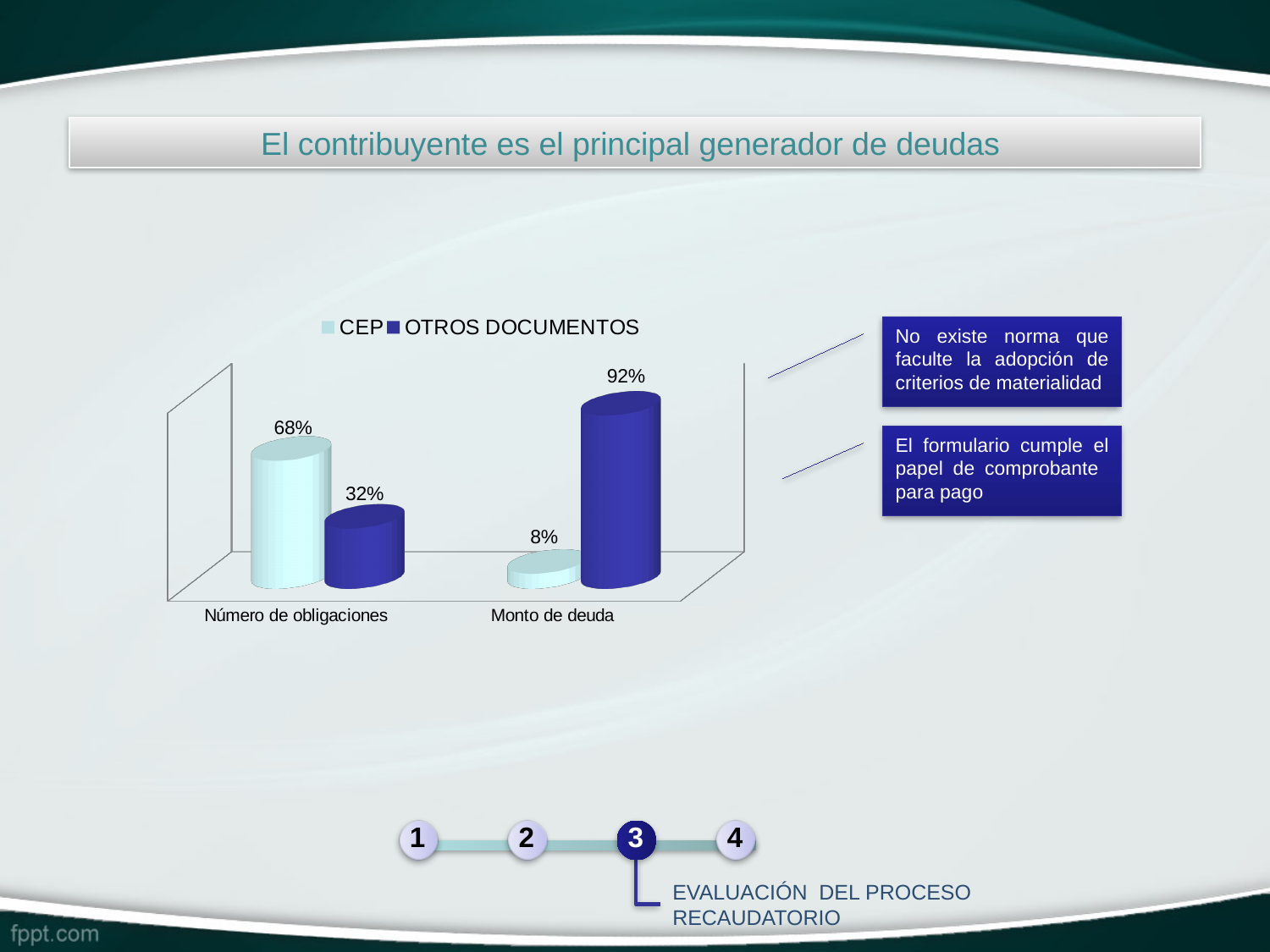
How many series does the legend list? 2 Which series has the lowest value in the Número de obligaciones category? OTROS DOCUMENTOS What is the value for OTROS DOCUMENTOS in the Monto de deuda category? 92% How many categories are shown on the x axis? 2 Which is larger: the CEP value for Número de obligaciones or the CEP value for Monto de deuda? Número de obligaciones Which series has the highest value in the Monto de deuda category? OTROS DOCUMENTOS What is the value for CEP in the Número de obligaciones category? 68% What is the value for CEP in the Monto de deuda category? 8% What is the value for OTROS DOCUMENTOS in the Número de obligaciones category? 32% What is the difference between the CEP and OTROS DOCUMENTOS values in the Número de obligaciones category? 36% What kind of chart is shown on the slide? Bar chart What is the difference between the OTROS DOCUMENTOS and CEP values in the Monto de deuda category? 84%